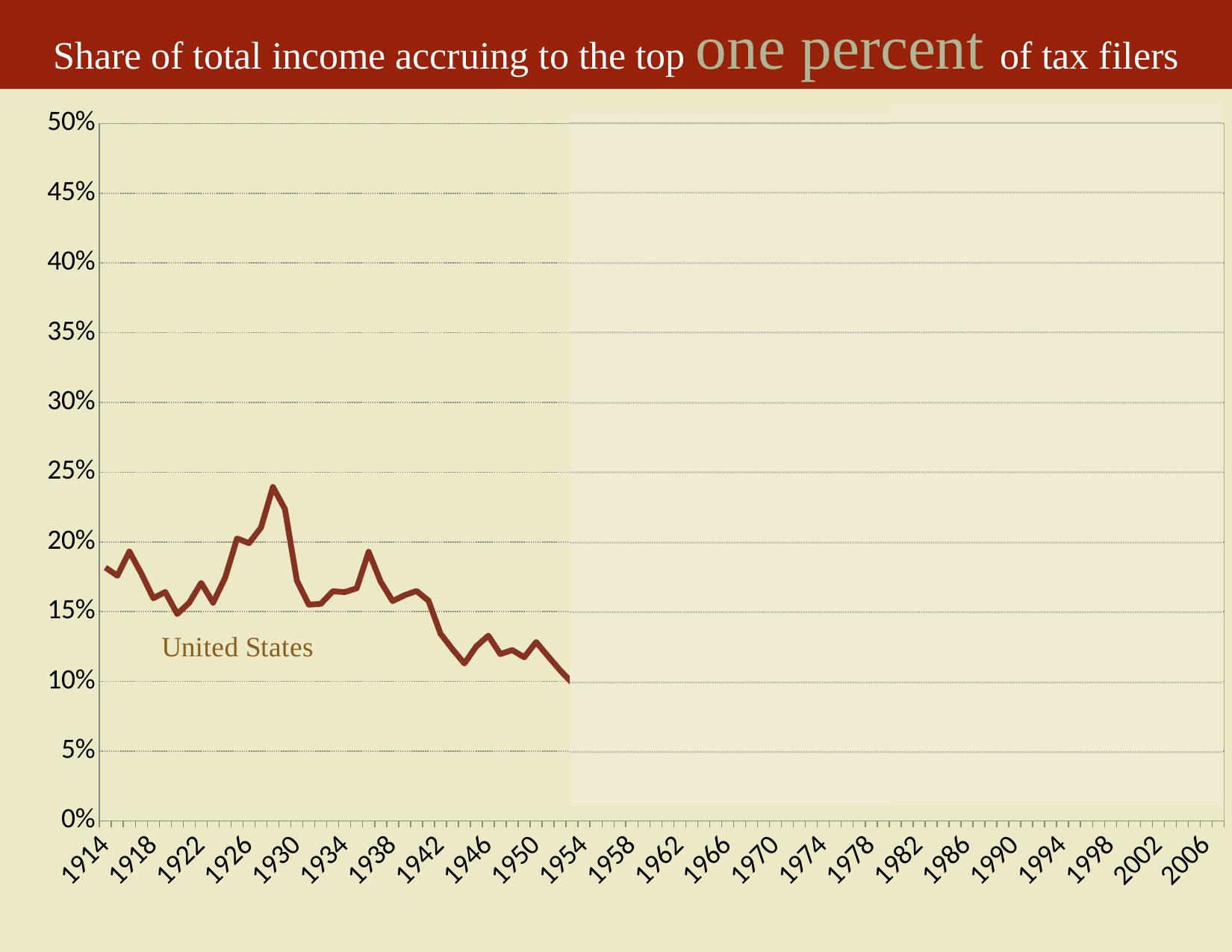
Which country does the plotted line represent? United States Is the value for the United States in 1953 greater or less than 15%? less What kind of chart is shown on the slide? line chart Is the value for the United States in 1929 greater or less than 20%? greater Is the value for the United States in 1914 greater or less than 15%? greater Which is larger, the United States value in 1929 or in 1953? 1929 In which year does the United States line reach its highest value? 1928 Which is larger, the United States value in 1914 or in 1945? 1914 What is the title of the chart? Share of total income accruing to the top one percent of tax filers Does the United States line generally rise or fall between 1929 and 1953? fall How many year labels are shown on the x axis? 24